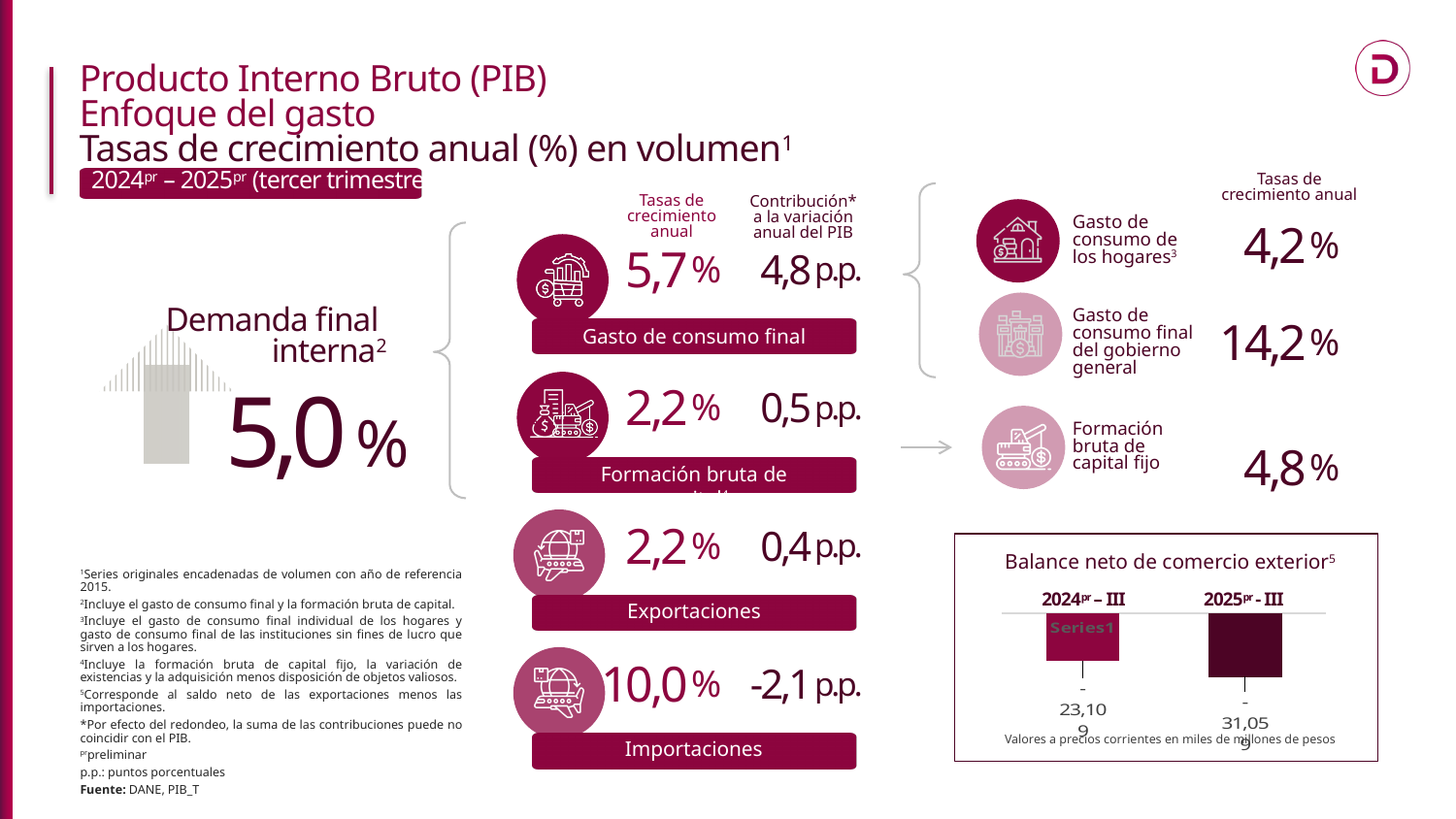
In the 'Balance neto de comercio exterior' chart, which period has the lower (more negative) value? 2025pr - III What are the two category labels on the 'Balance neto de comercio exterior' chart? 2024pr – III and 2025pr - III Do the values in the 'Balance neto de comercio exterior' chart rise or fall from 2024pr – III to 2025pr - III? fall In the 'Balance neto de comercio exterior' chart, which period has the higher (less negative) value? 2024pr – III How many bars are plotted in the 'Balance neto de comercio exterior' chart? 2 In the 'Balance neto de comercio exterior' chart, is the bar for 2025pr - III larger or smaller than the bar for 2024pr – III? larger Are the bars in the 'Balance neto de comercio exterior' chart positive or negative? negative What is the value shown for 2025pr - III in the 'Balance neto de comercio exterior' chart? -31,059 What kind of chart is shown in the 'Balance neto de comercio exterior' box? bar chart What is the value shown for 2024pr – III in the 'Balance neto de comercio exterior' chart? -23,109